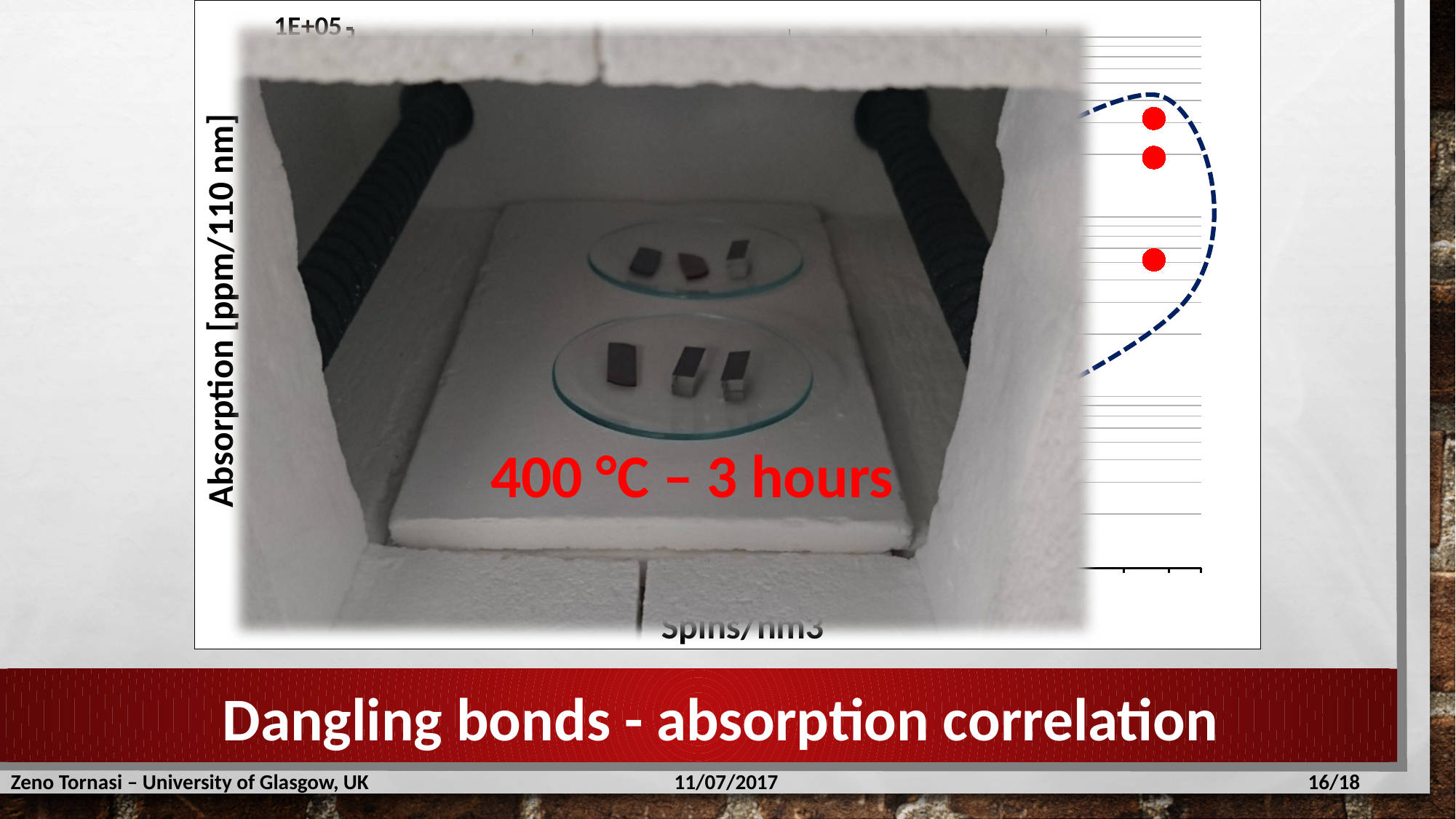
What is the label of the vertical axis of the chart? Absorption [ppm/110 nm] What is the topmost tick label shown on the vertical axis of the chart? 1E+05 What is the label of the horizontal axis of the chart? Spins/nm3 How many red data points are visible on the chart to the right of the photograph? 3 What kind of chart is partially visible behind the photograph on the slide? scatter chart